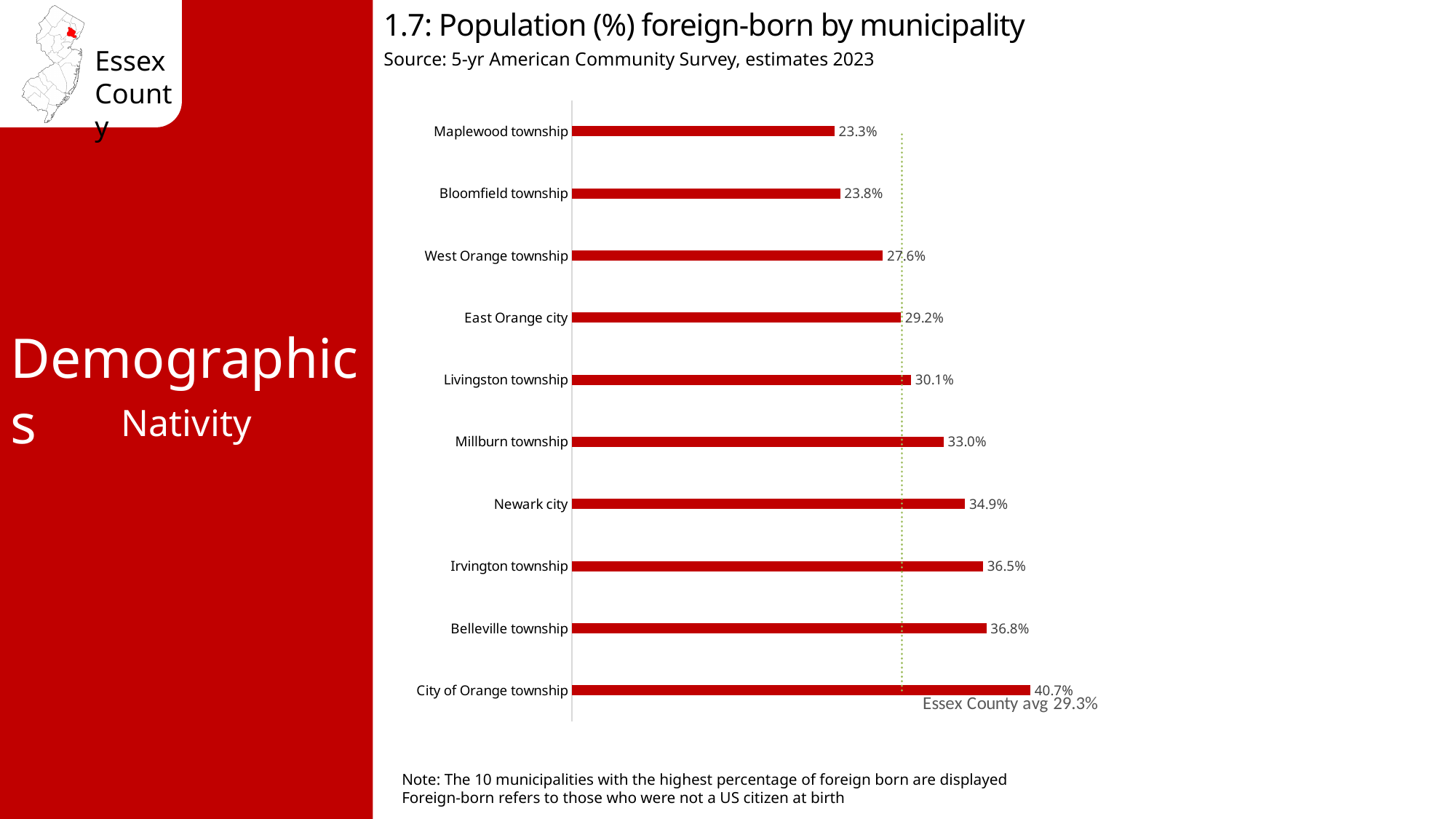
What is the foreign-born population percentage for Maplewood township? 23.3% Which municipality has the lowest foreign-born population percentage? Maplewood township How many municipalities are shown in the chart? 10 What is the difference in foreign-born percentage between Irvington township and Millburn township? 3.5% What is the foreign-born population percentage for Livingston township? 30.1% What is the Essex County average foreign-born percentage shown by the dotted line? 29.3% Which municipality has the highest foreign-born population percentage? City of Orange township What kind of chart is shown on the slide? Bar chart What is the source of the data shown in the chart? 5-yr American Community Survey, estimates 2023 Which has a higher foreign-born percentage, West Orange township or East Orange city? East Orange city What is the difference in foreign-born percentage between City of Orange township and Belleville township? 3.9% What is the foreign-born population percentage for Newark city? 34.9%